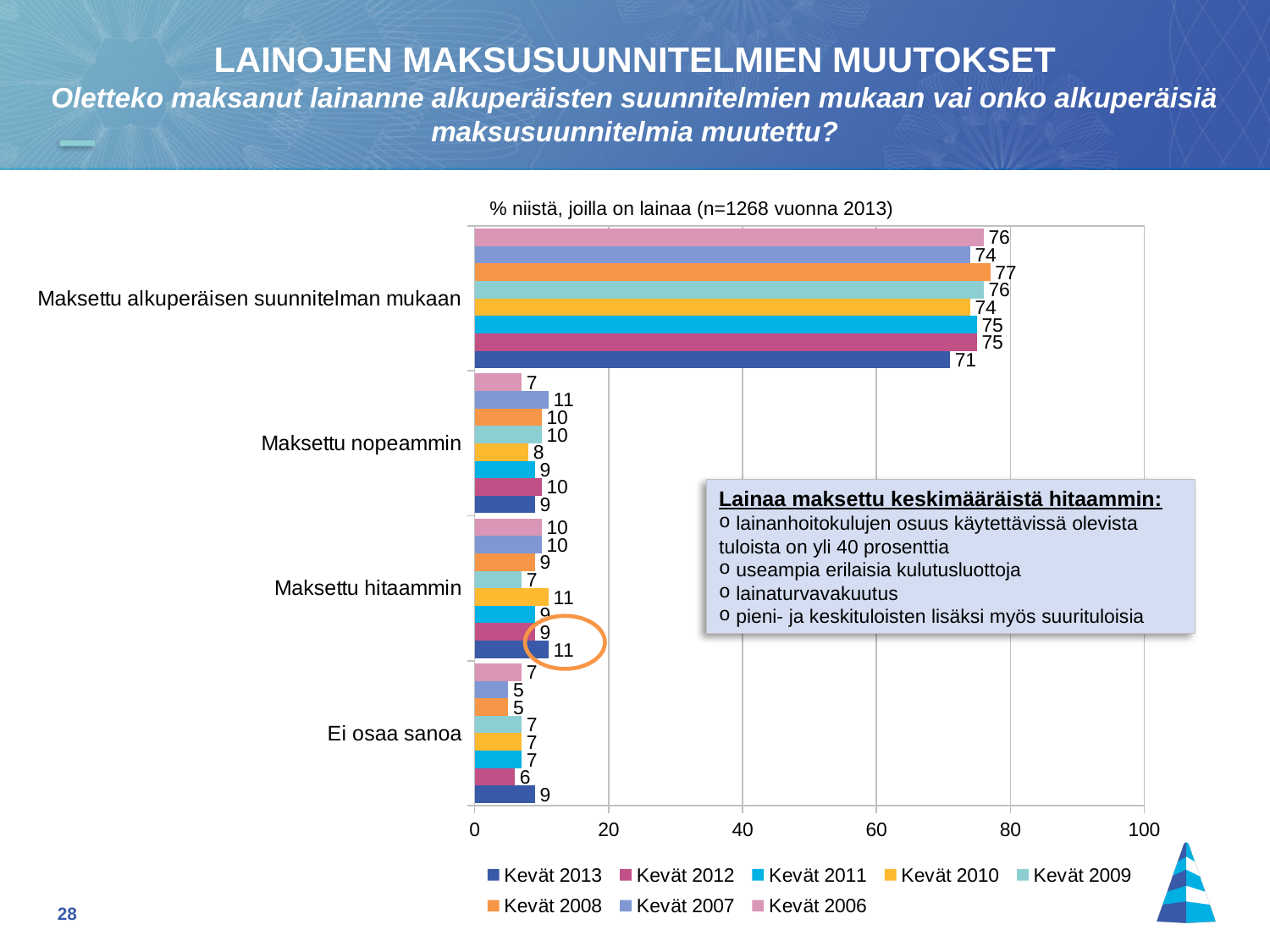
Which series has the lowest value in the category "Maksettu alkuperäisen suunnitelman mukaan"? Kevät 2013 Is the value for Kevät 2013 in "Maksettu alkuperäisen suunnitelman mukaan" greater or less than 60? greater What is the value for Kevät 2010 in the category "Maksettu hitaammin"? 11 What is the value for Kevät 2013 in the category "Maksettu alkuperäisen suunnitelman mukaan"? 71 What is the value for Kevät 2008 in the category "Maksettu alkuperäisen suunnitelman mukaan"? 77 In the category "Maksettu nopeammin", which is larger: the value for Kevät 2013 or the value for Kevät 2006? Kevät 2013 What kind of chart is shown on the slide? bar chart How many categories are shown on the chart? 4 Which series has the highest value in the category "Maksettu alkuperäisen suunnitelman mukaan"? Kevät 2008 What is the value for Kevät 2013 in the category "Ei osaa sanoa"? 9 How many series does the legend list? 8 In the category "Maksettu alkuperäisen suunnitelman mukaan", what is the difference between the Kevät 2008 value and the Kevät 2013 value? 6